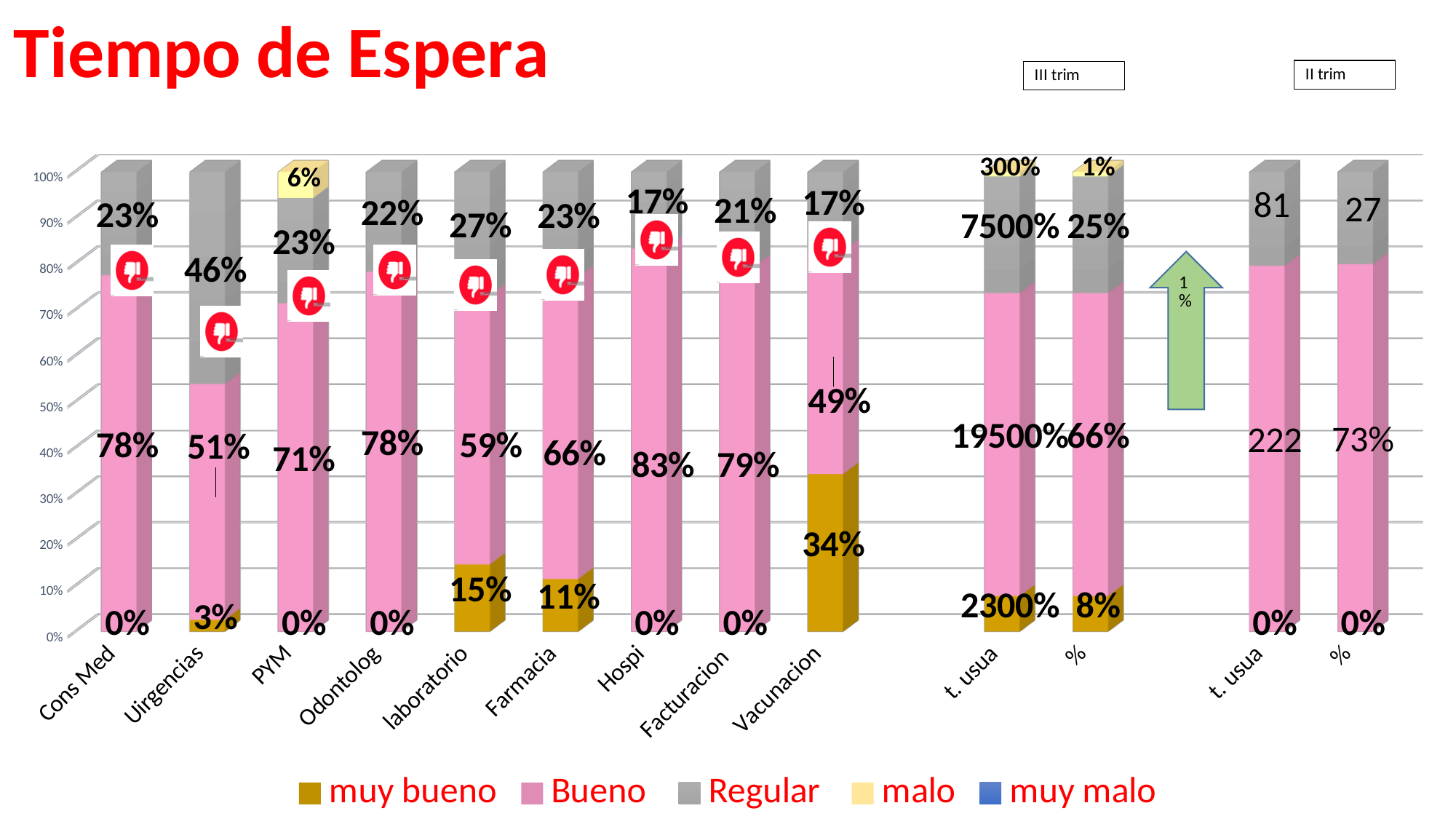
What is the Bueno value for Hospi? 83% What is the title of the chart? Tiempo de Espera What is the malo value for PYM? 6% What is the Regular value for Uirgencias? 46% What is the Bueno value for the '%' category under II trim? 73% Which category has the highest Bueno value among the service categories (Cons Med through Vacunacion)? Hospi Which category has the lowest Bueno value among the service categories (Cons Med through Vacunacion)? Vacunacion What is the difference between the Bueno values for Cons Med and Uirgencias? 27% What is the muy bueno value for Vacunacion? 34% How many series does the legend list? 5 Which is larger, the muy bueno value for laboratorio or for Farmacia? laboratorio What type of chart is shown on the slide? stacked bar chart